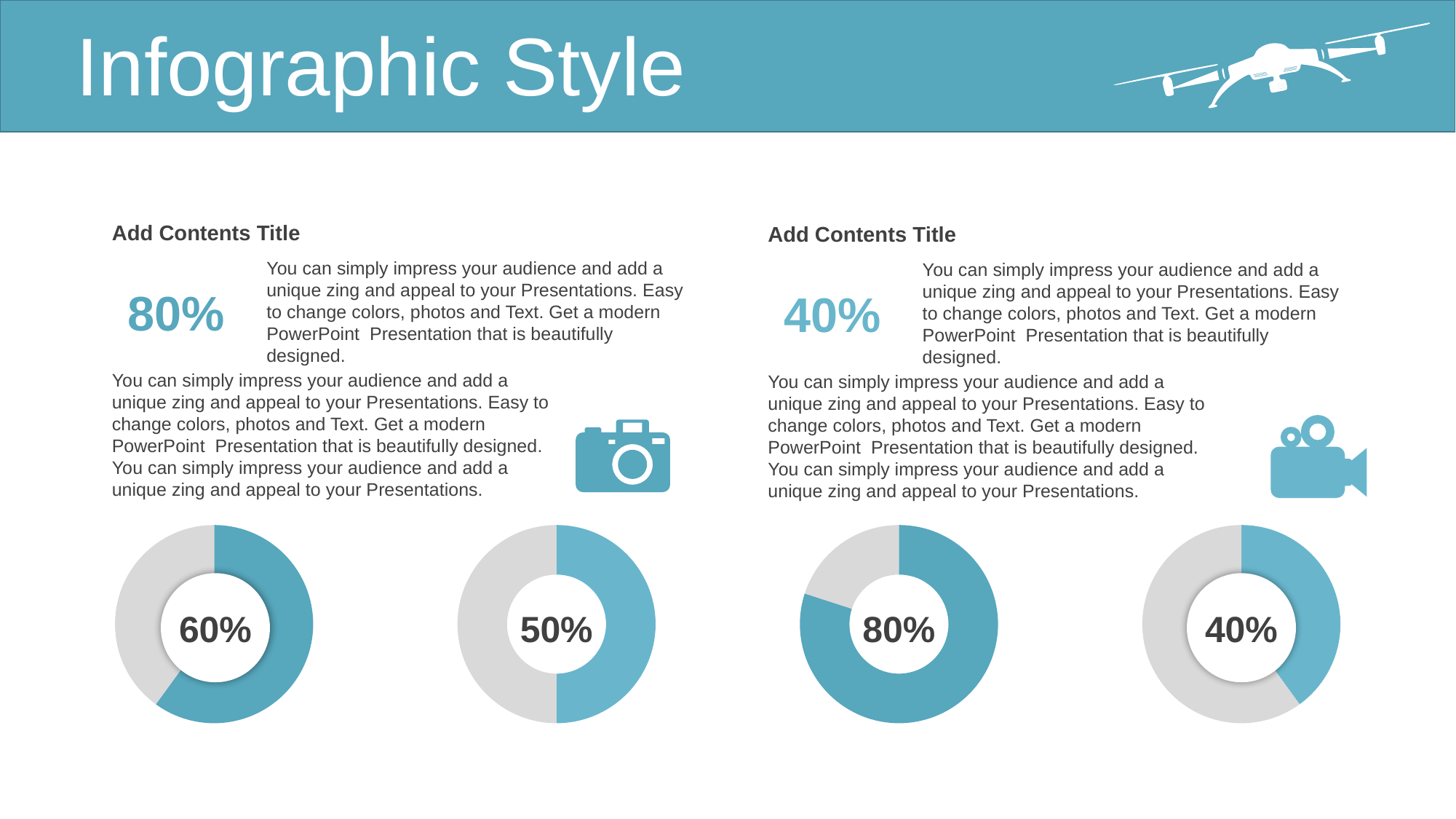
What value is shown in the centre of the third donut chart from the left? 80% What colour is used for the filled portion of each donut chart? Blue What kind of chart is used for the four charts at the bottom of the slide? Donut chart What is the difference between the value in the third donut chart from the left and the value in the rightmost donut chart? 40% Which donut chart shows the lowest percentage? The rightmost (40%) How many donut charts are shown on the slide? 4 Which is larger: the value in the leftmost donut chart or the value in the second donut chart from the left? The leftmost (60%) In the second donut chart from the left, what share of the ring is filled in blue? 50% What value is shown in the centre of the leftmost donut chart? 60% What value is shown in the centre of the rightmost donut chart? 40% What value is shown in the centre of the second donut chart from the left? 50% Which donut chart shows the highest percentage? The third from the left (80%)